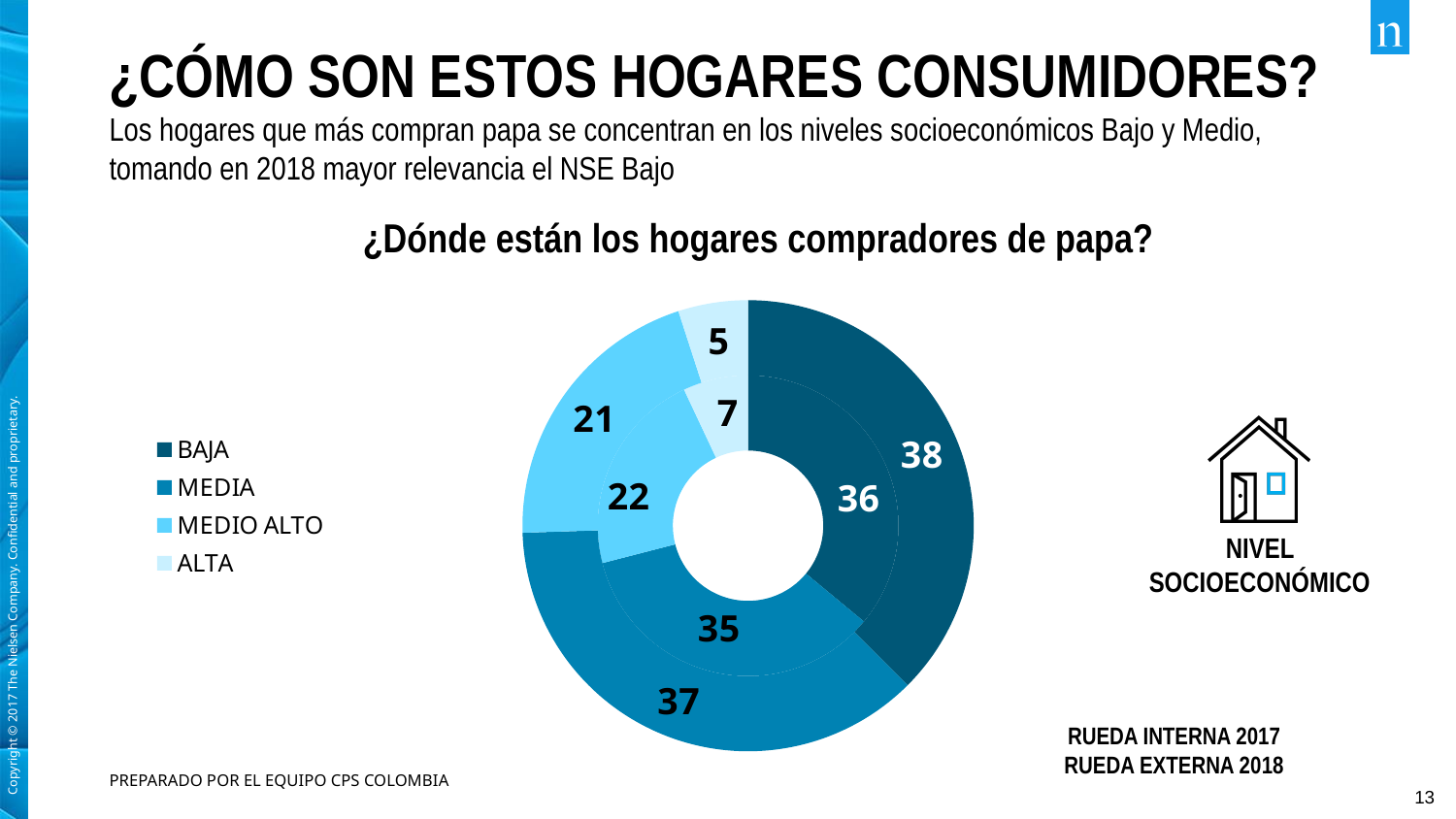
Which is larger in the inner ring (2017): MEDIO ALTO or ALTA? MEDIO ALTO Which category has the largest value in the outer ring (2018)? BAJA What is the difference between the BAJA value in 2018 (outer ring) and in 2017 (inner ring)? 2 How many categories does the legend list? 4 What kind of chart is shown on the slide? Doughnut chart In the outer ring (2018), what is the value for BAJA? 38 Which year does the outer ring of the chart represent? 2018 What is the title of the chart? ¿Dónde están los hogares compradores de papa? Which category has the smallest value in the inner ring (2017)? ALTA In the inner ring (2017), what is the value for MEDIA? 35 In the outer ring (2018), what is the value for ALTA? 5 In the inner ring (2017), what is the value for MEDIO ALTO? 22